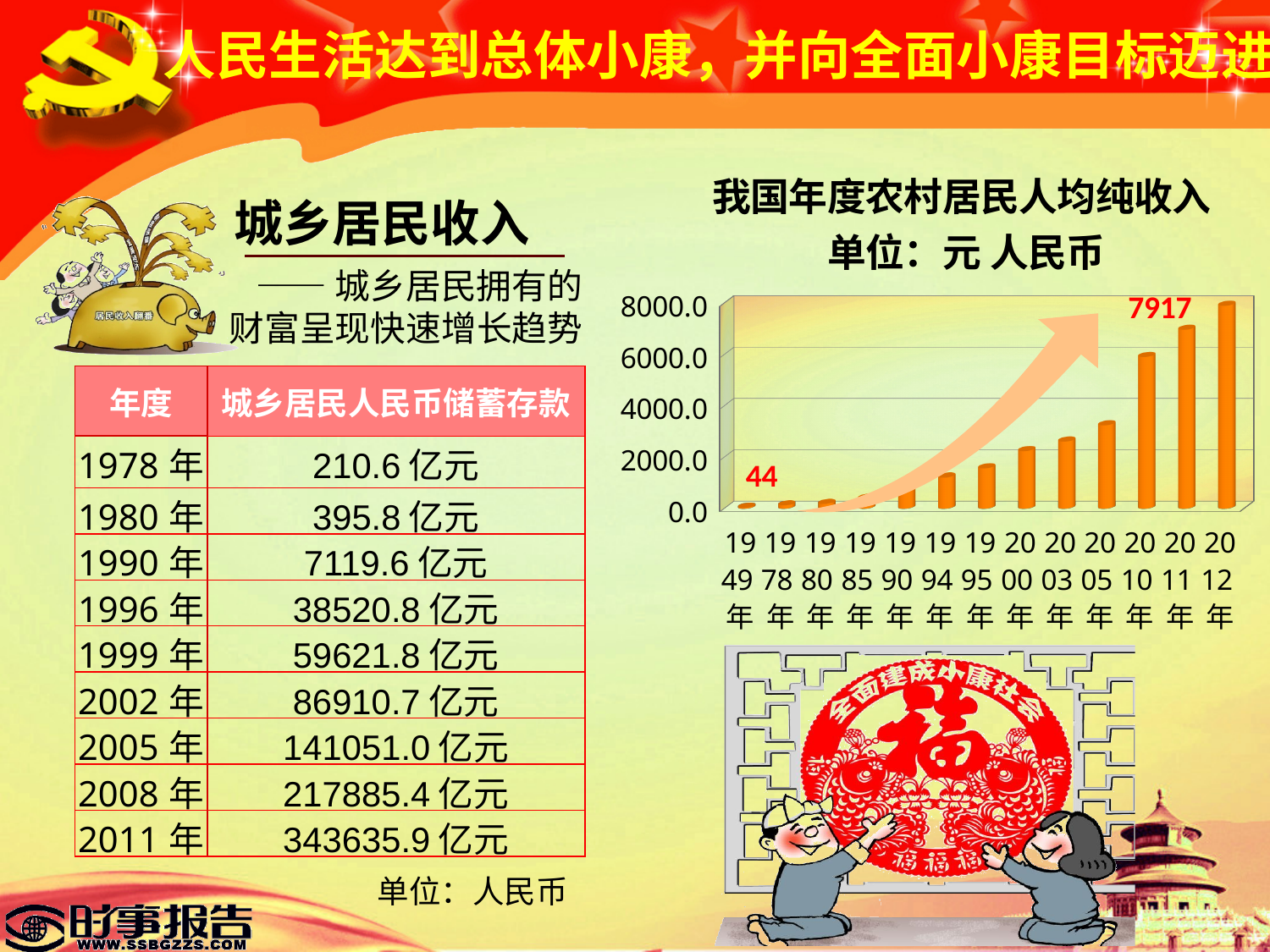
Is the value for 2010年 greater or less than 4000.0? greater Do the values rise or fall from 1949年 to 2012年? rise Is the value for 2005年 greater or less than 4000.0? less Which is larger, the value for 2011年 or the value for 2010年? 2011年 What is the value for 1949年 in the chart? 44 Which year has the highest value in the chart? 2012年 How many years are shown on the x axis of the chart? 13 What kind of chart is shown on the slide? bar chart Which year has the lowest value in the chart? 1949年 What is the difference between the values for 2012年 and 1949年? 7873 What is the value for 2012年 in the chart? 7917 What unit does the chart title state the values are in? 元 人民币